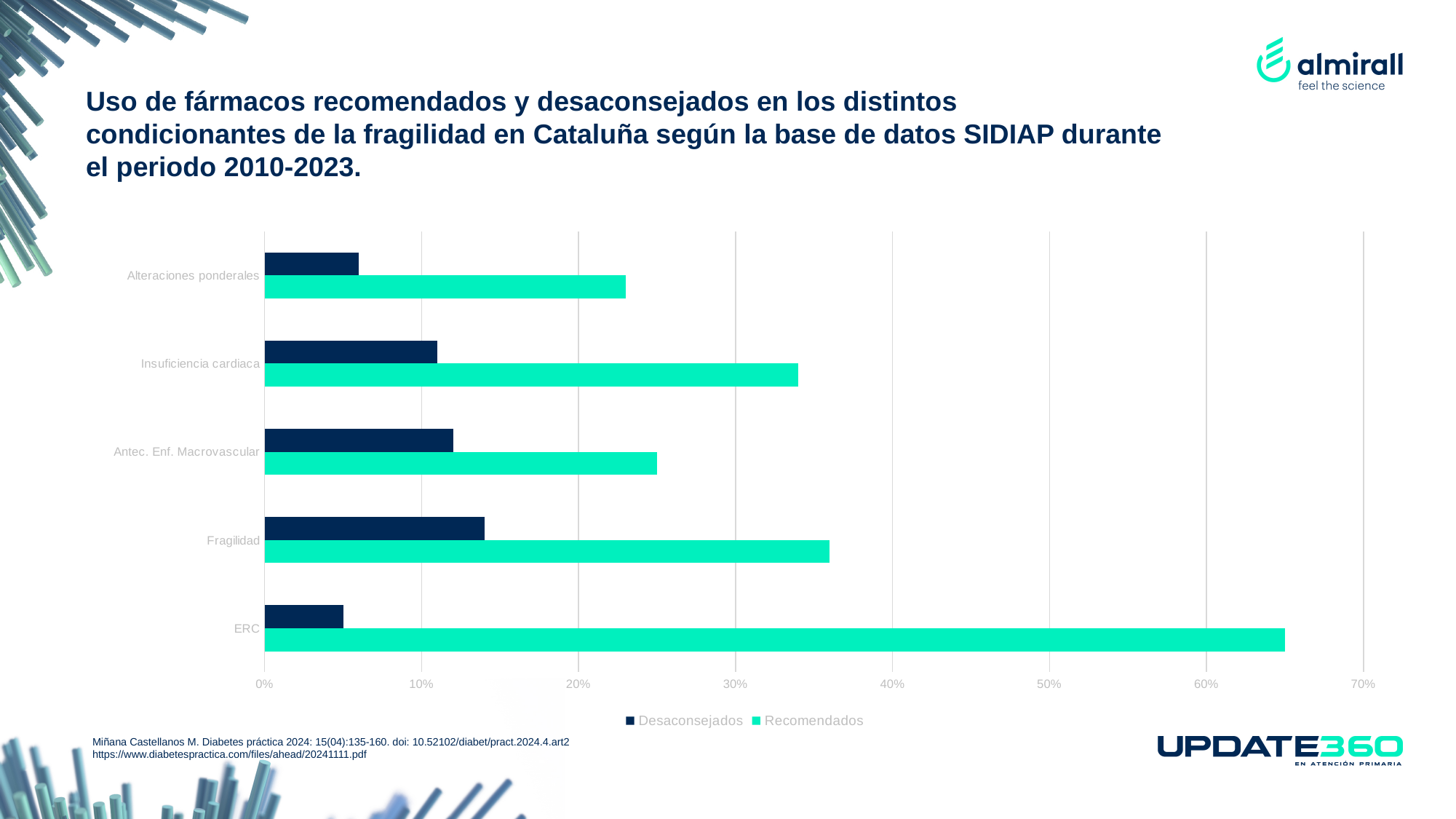
How many series does the legend list? 2 Which category has the highest value for Desaconsejados? Fragilidad What kind of chart is shown on the slide? Bar chart Is the Desaconsejados value for Alteraciones ponderales greater or less than 10%? less Is the Recomendados value for Fragilidad greater or less than 30%? greater For Antec. Enf. Macrovascular, which is larger: Recomendados or Desaconsejados? Recomendados Is the Recomendados value for Insuficiencia cardiaca greater or less than 30%? greater Which category has the highest value for Recomendados? ERC How many categories are shown on the vertical axis of the chart? 5 Which series is shown in dark navy in the legend? Desaconsejados